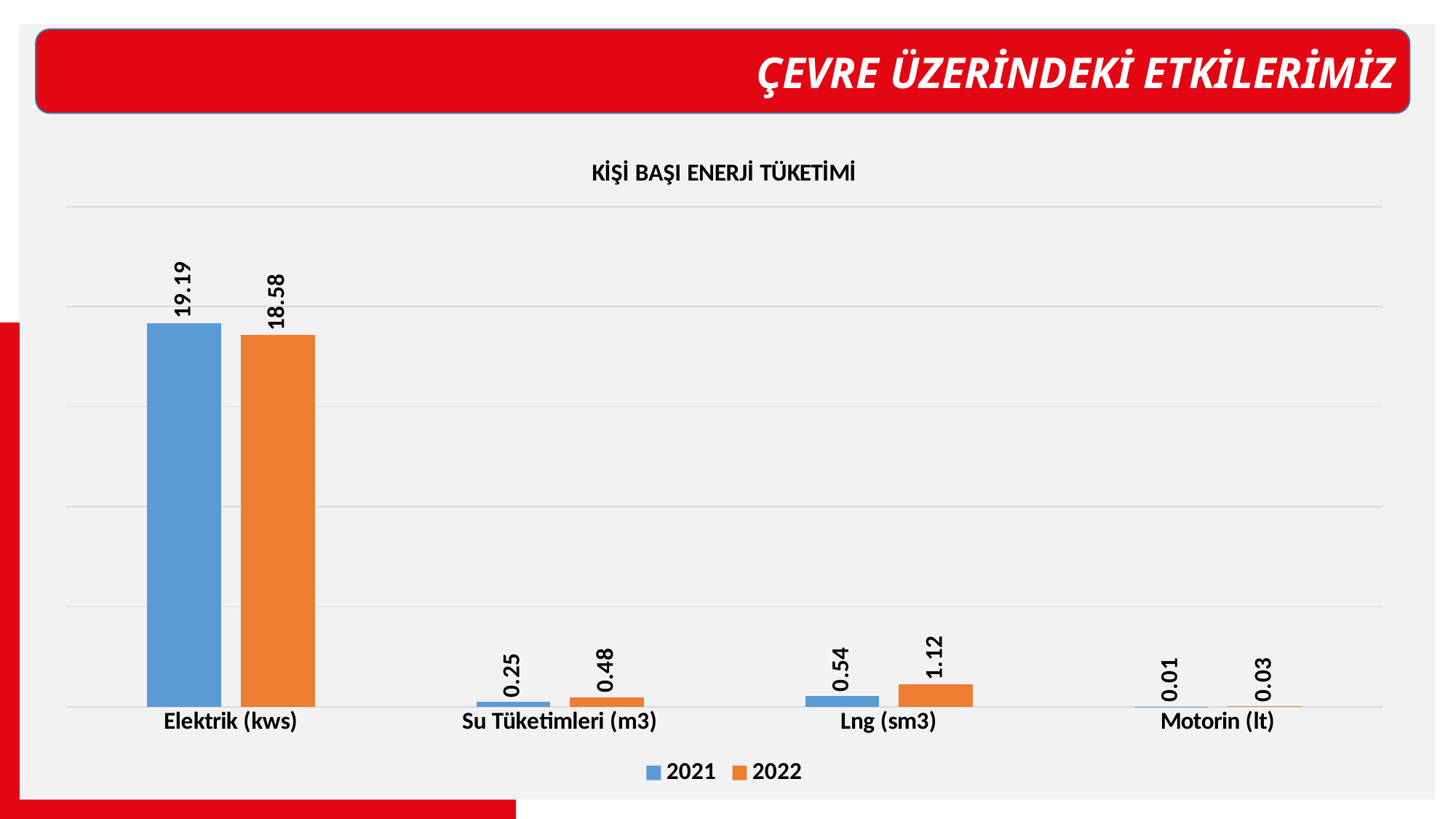
Which category has the lowest 2021 value? Motorin (lt) Which is larger for Lng (sm3): the 2021 value or the 2022 value? 2022 What is the difference between the 2021 and 2022 values for Elektrik (kws)? 0.61 What kind of chart is shown? Bar chart What is the 2021 value for Elektrik (kws)? 19.19 What is the 2022 value for Lng (sm3)? 1.12 What is the 2021 value for Su Tüketimleri (m3)? 0.25 What is the title of the chart? KİŞİ BAŞI ENERJİ TÜKETİMİ What is the 2022 value for Motorin (lt)? 0.03 Which category has the highest 2022 value? Elektrik (kws) How many categories are shown on the x axis? 4 How many series does the legend list? 2